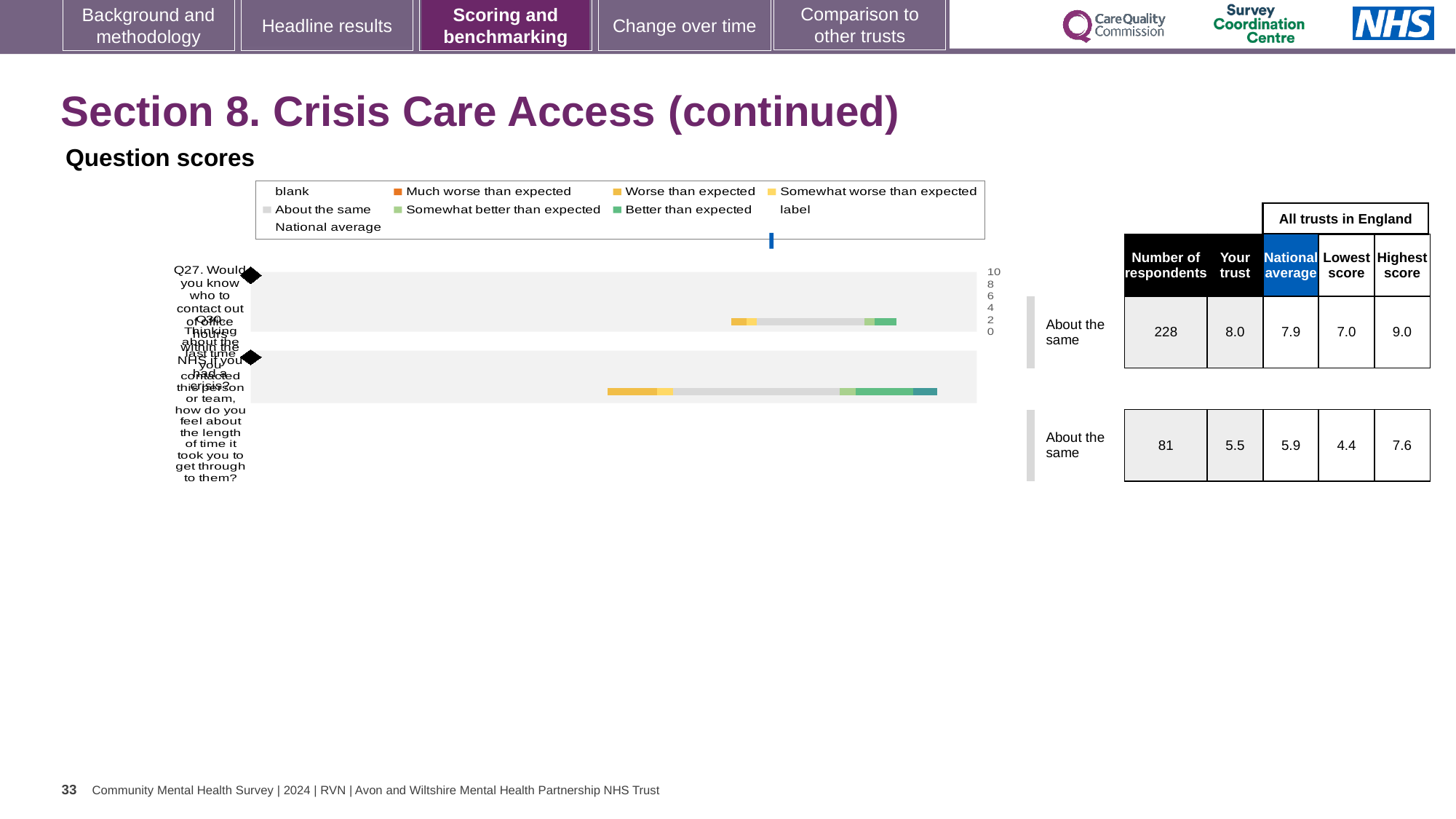
How many questions (bars) are plotted in the question scores chart? 2 In the table beside the chart, what is the number of respondents for the first (top) question, Q27? 228 For the first (top) question, Q27, which is larger: the 'Your trust' score or the national average? Your trust In the table beside the chart, what is the 'Your trust' score for the first (top) question, Q27? 8.0 What benchmark rating is shown next to both bars in the chart? About the same For the second (bottom) question, Q28, what is the difference between the highest score and the lowest score among all trusts in England? 3.2 Which of the two questions has the larger number of respondents? Q27 In the table beside the chart, what is the lowest score among all trusts in England for the second (bottom) question, Q28? 4.4 What kind of chart is used to show the question scores on this slide? bar chart In the table beside the chart, what is the highest score among all trusts in England for the first (top) question, Q27? 9.0 In the table beside the chart, what is the national average for the second (bottom) question, Q28? 5.9 In the chart legend, what colour represents 'Much worse than expected'? orange